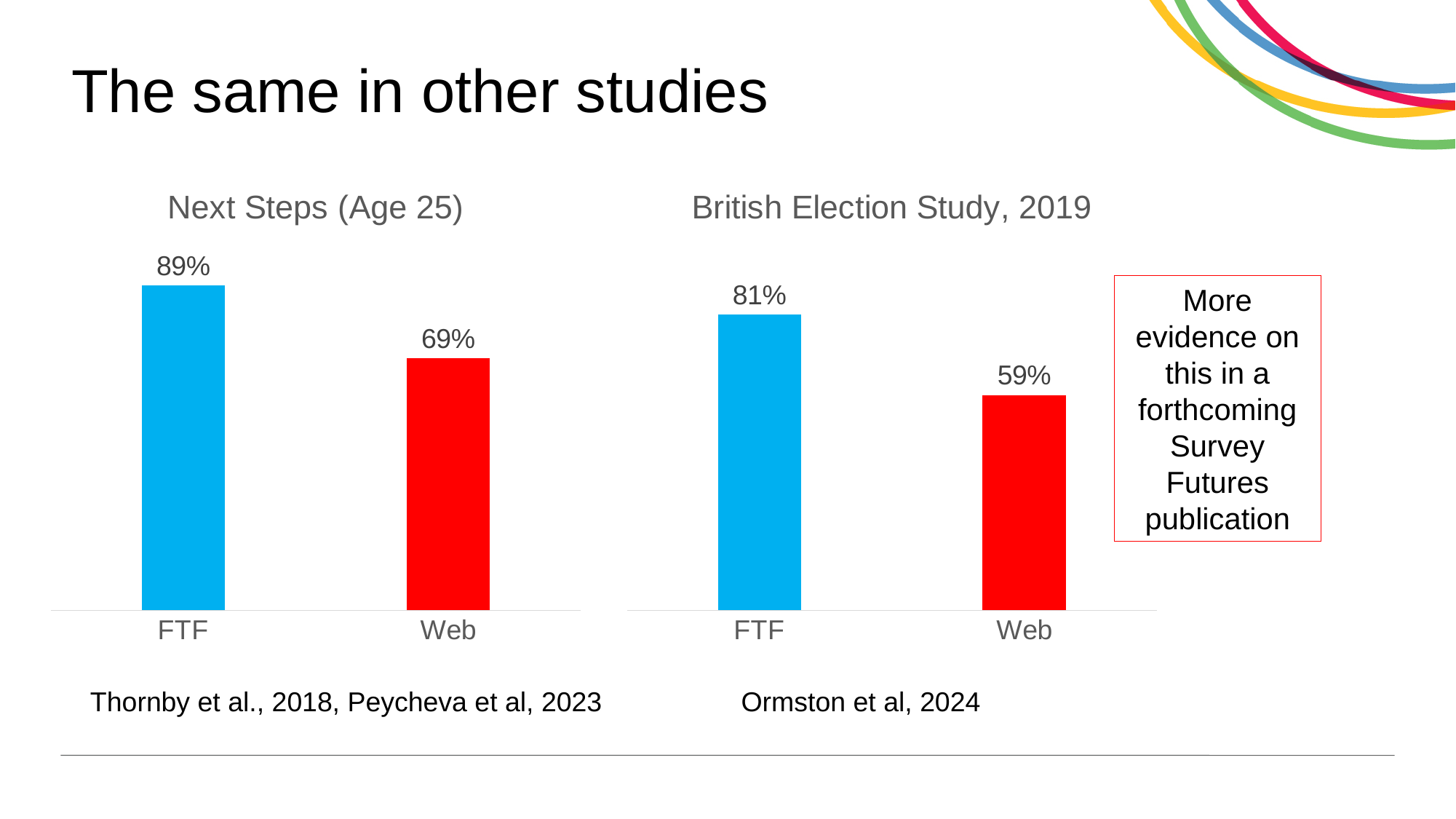
In the 'British Election Study, 2019' chart, which is larger, FTF or Web? FTF In the 'Next Steps (Age 25)' chart, what is the difference between the FTF and Web values? 20% How many categories are shown in the 'Next Steps (Age 25)' chart? 2 In the 'British Election Study, 2019' chart, what is the value for Web? 59% In the 'Next Steps (Age 25)' chart, what is the value for Web? 69% In the 'Next Steps (Age 25)' chart, what is the value for FTF? 89% In the 'Next Steps (Age 25)' chart, which category has the highest value? FTF What kind of chart is the 'British Election Study, 2019' chart? Bar chart In the 'British Election Study, 2019' chart, what is the difference between the FTF and Web values? 22% In the 'British Election Study, 2019' chart, what is the value for FTF? 81% In the 'British Election Study, 2019' chart, which category has the lowest value? Web In the 'Next Steps (Age 25)' chart, what colour is the Web bar? Red